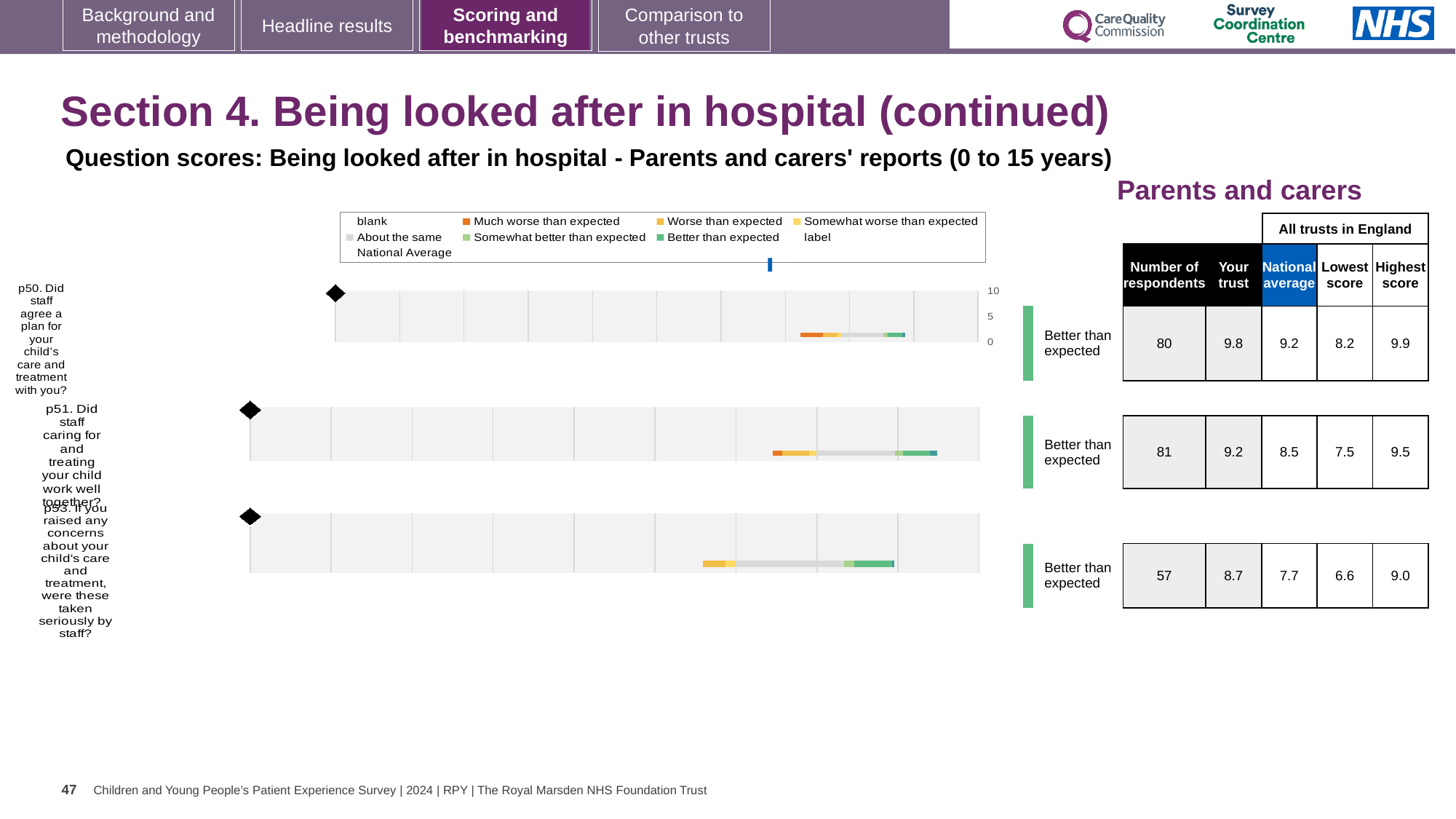
What benchmarking category is shown for question p53? Better than expected What kind of chart is used to show the benchmarking for each question on this slide? bar chart For question p50 (Did staff agree a plan for your child's care and treatment with you?), how many respondents are shown? 80 For question p51, what is the highest score among all trusts in England? 9.5 For question p51, which is larger: the 'Your trust' score or the national average? Your trust What colour does the legend use for 'Much worse than expected'? orange For question p50, what is the difference between the 'Your trust' score and the national average? 0.6 Which question has the lowest number of respondents? p53 For question p53 (If you raised any concerns about your child's care and treatment, were these taken seriously by staff?), what is the national average score? 7.7 Which question has the highest 'Your trust' score on this slide? p50 For question p51 (Did staff caring for and treating your child work well together?), what is the 'Your trust' score? 9.2 How many survey questions (p50, p51, p53) are charted on this slide? 3